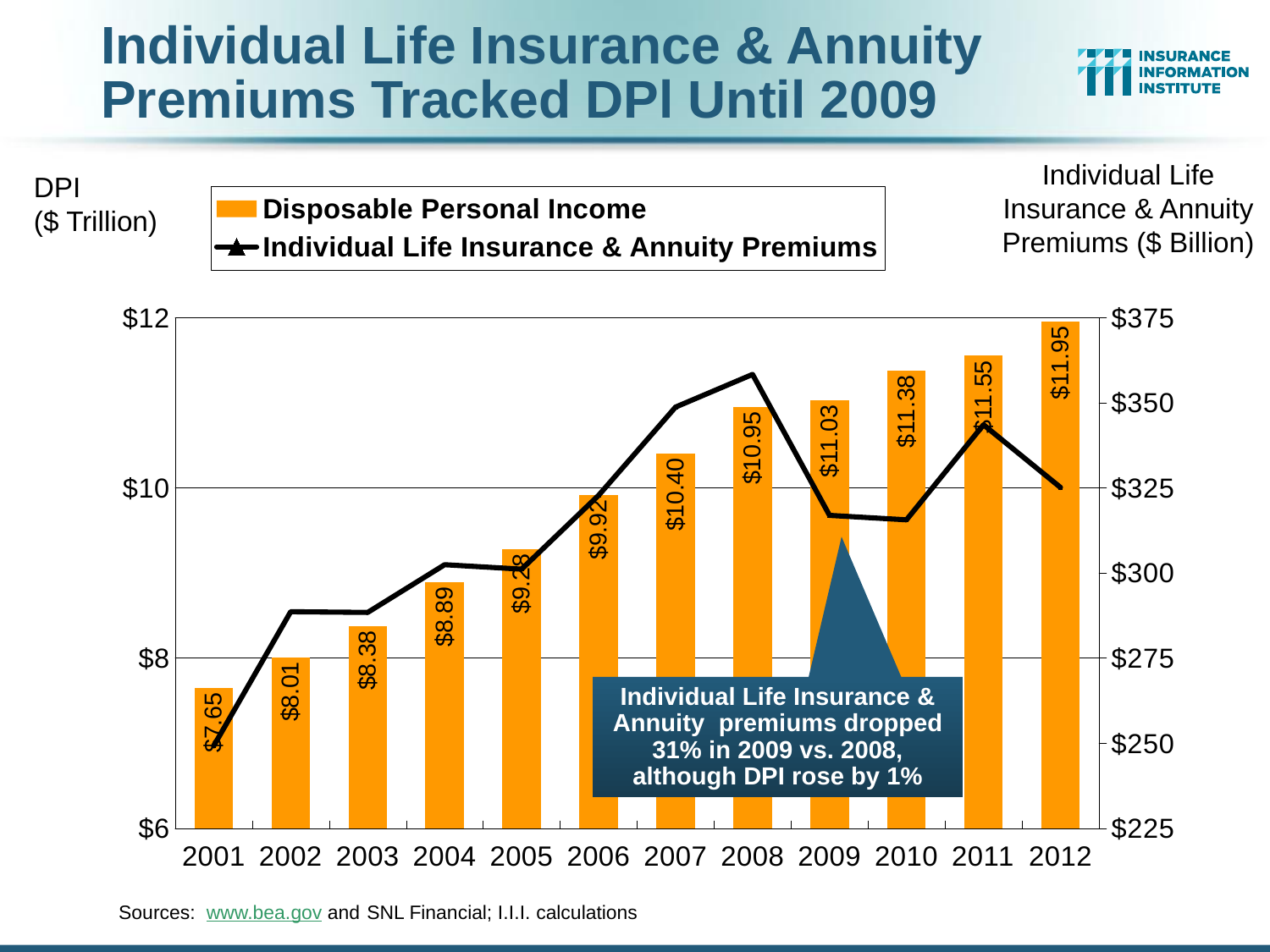
Which year has the highest Disposable Personal Income bar? 2012 Is the Individual Life Insurance & Annuity Premiums value for 2008 greater or less than $350? greater Which year has the lowest Disposable Personal Income bar? 2001 What is the Disposable Personal Income value shown for 2012? $11.95 How many years are shown on the x axis of the chart? 12 How many series does the legend list? 2 Which is larger, the Disposable Personal Income value for 2005 or for 2006? 2006 What is the difference between the Disposable Personal Income values for 2012 and 2001? $4.30 Does Disposable Personal Income rise or fall from 2001 to 2012? rise Is the Individual Life Insurance & Annuity Premiums value for 2009 greater or less than $325? less What is the Disposable Personal Income value shown for 2001? $7.65 What is the Disposable Personal Income value shown for 2008? $10.95